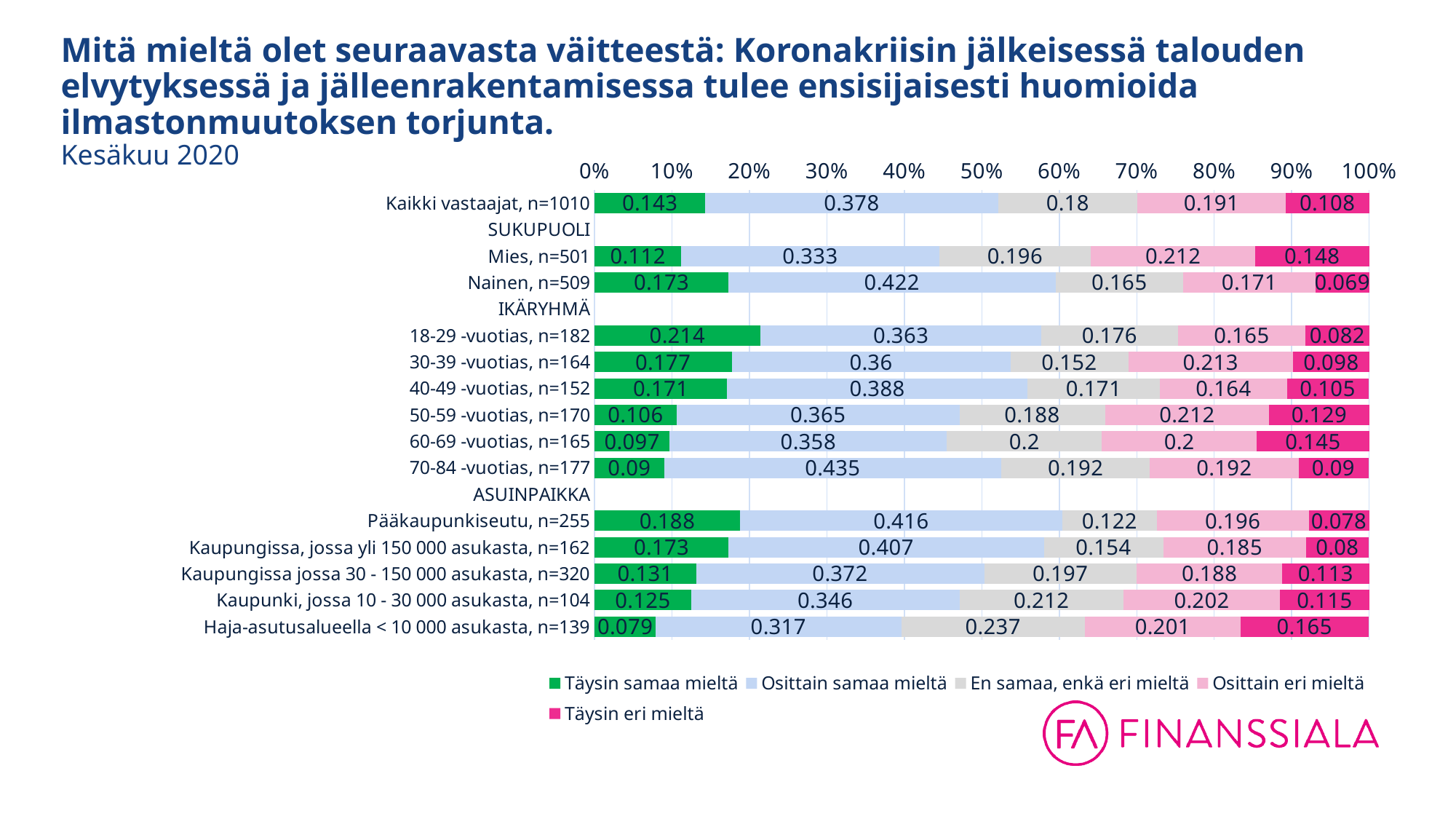
What is the value of 'Osittain samaa mieltä' for 'Nainen, n=509'? 0.422 Which category has the lowest value for 'Täysin samaa mieltä'? Haja-asutusalueella < 10 000 asukasta, n=139 What kind of chart is shown on the slide? Stacked bar chart What is the difference in 'Täysin samaa mieltä' between 'Nainen, n=509' and 'Mies, n=501'? 0.061 How many series does the legend list? 5 Which category has the highest value for 'Täysin samaa mieltä'? 18-29 -vuotias, n=182 What is the value of 'En samaa, enkä eri mieltä' for 'Pääkaupunkiseutu, n=255'? 0.122 What is the value of 'Täysin eri mieltä' for 'Haja-asutusalueella < 10 000 asukasta, n=139'? 0.165 Which has a larger 'Osittain samaa mieltä' value: '70-84 -vuotias, n=177' or 'Pääkaupunkiseutu, n=255'? 70-84 -vuotias, n=177 Which category has the lowest value for 'Täysin eri mieltä'? Nainen, n=509 How many respondent groups (bars) are plotted in the chart? 14 What is the value of 'Täysin samaa mieltä' for 'Kaikki vastaajat, n=1010'? 0.143